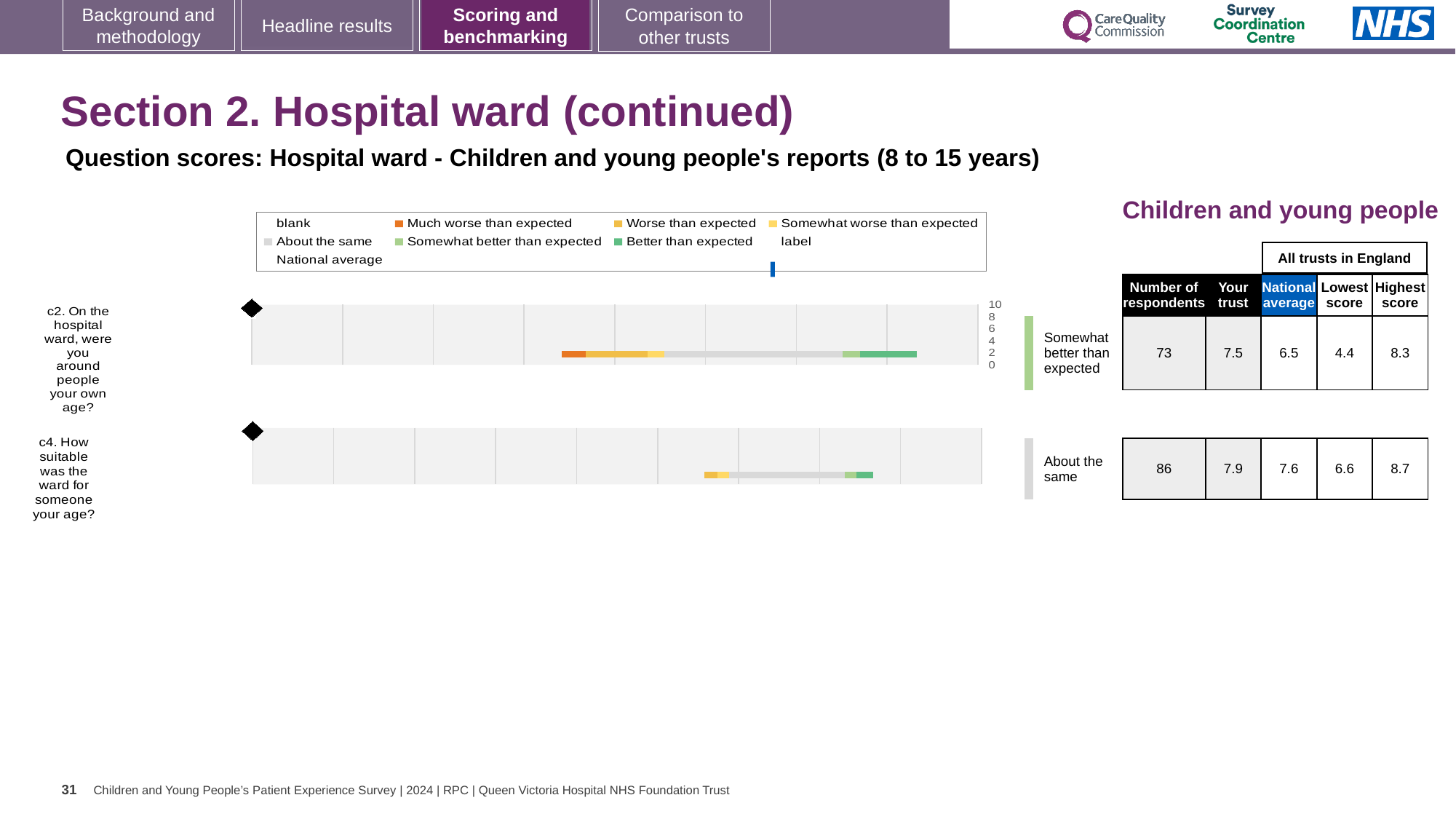
How many respondents answered question c4? 86 What kind of chart is used to show the question scores for c2 and c4? bar chart What is the difference between the highest and lowest scores for question c2? 3.9 What is the 'Your trust' score for question c2 (On the hospital ward, were you around people your own age?)? 7.5 How many survey questions are plotted on the slide? 2 Which question has the higher 'Your trust' score, c2 or c4? c4 What is the difference between the 'Your trust' score and the national average for question c2? 1.0 What is the highest score among all trusts in England for question c4? 8.7 Which benchmark category is question c4 rated in? About the same What is the national average score for question c2? 6.5 Which benchmark category is question c2 rated in? Somewhat better than expected What is the 'Your trust' score for question c4 (How suitable was the ward for someone your age?)? 7.9